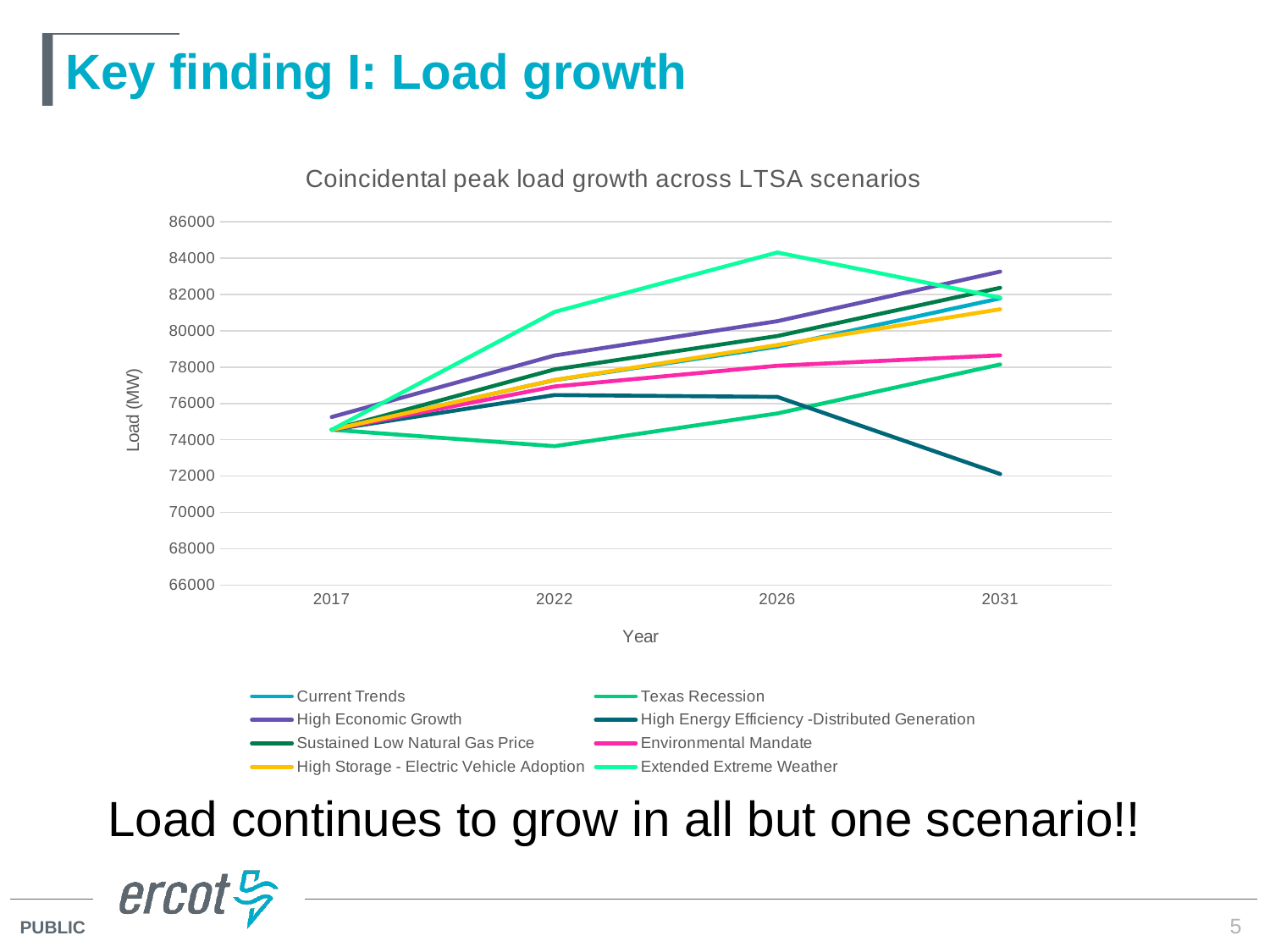
Does the High Energy Efficiency -Distributed Generation line rise or fall between 2026 and 2031? Fall In 2022, which is larger: High Energy Efficiency -Distributed Generation or Texas Recession? High Energy Efficiency -Distributed Generation How many years are plotted along the x axis? 4 Is the value for Environmental Mandate in 2031 greater or less than 80000? less What kind of chart is shown on the slide? Line chart Is the value for Extended Extreme Weather in 2026 greater or less than 82000? greater How many series does the legend list? 8 Is the value for High Energy Efficiency -Distributed Generation in 2031 greater or less than 74000? less Which scenario has the lowest load in 2031? High Energy Efficiency -Distributed Generation What is the label on the y axis of the chart? Load (MW) Which scenario has the lowest load in 2022? Texas Recession Which scenario has the highest load in 2026? Extended Extreme Weather